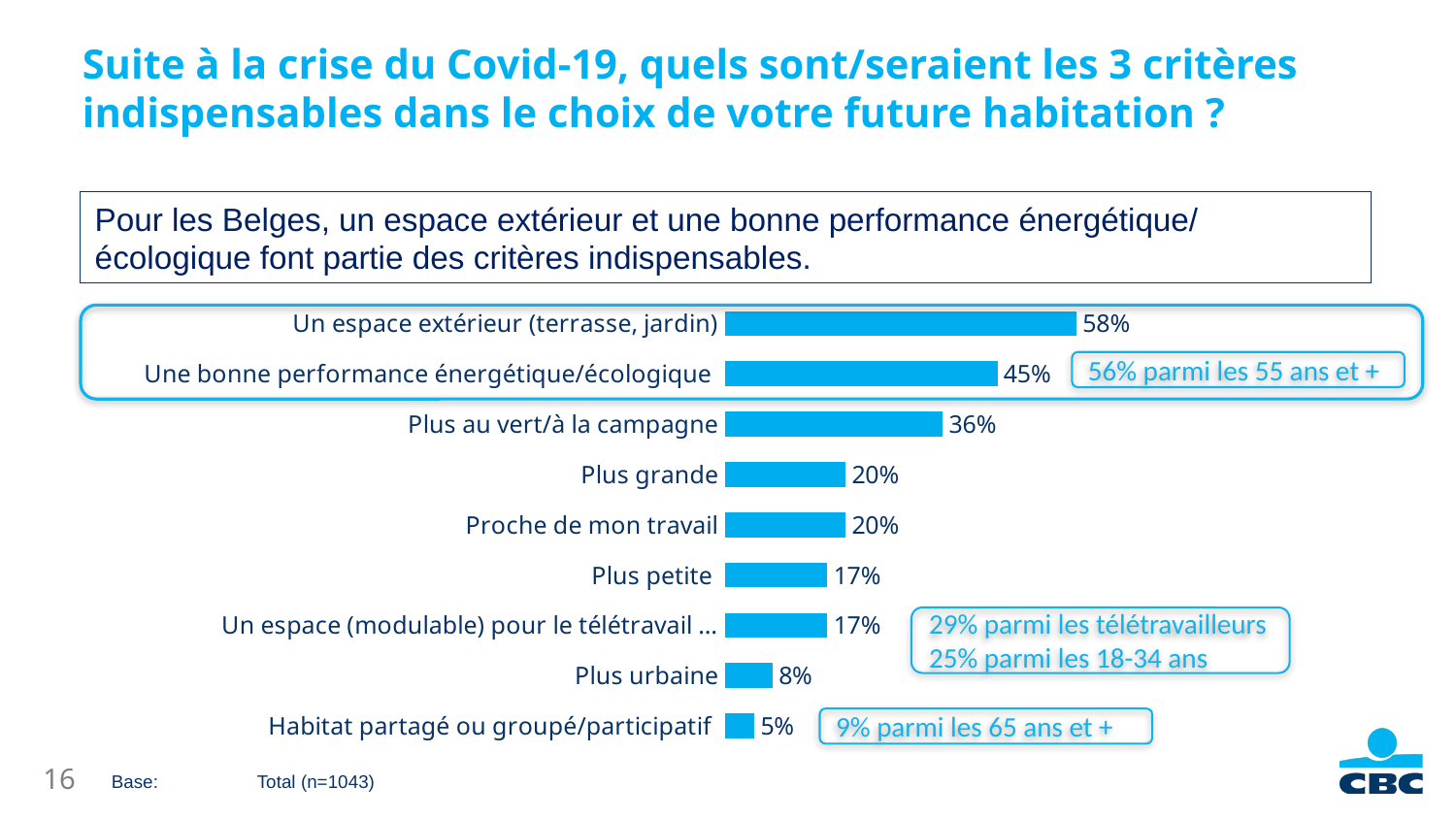
Which category has the lowest value? Habitat partagé ou groupé/participatif What is the difference between "Plus petite" and "Plus urbaine"? 9% What is the sample size (base) stated on the slide? n=1043 What is the value for "Plus urbaine"? 8% What is the value for "Plus au vert/à la campagne"? 36% What is the difference between "Un espace extérieur (terrasse, jardin)" and "Une bonne performance énergétique/écologique"? 13% Which is larger: "Plus au vert/à la campagne" or "Plus grande"? Plus au vert/à la campagne What percentage of respondents chose "Un espace extérieur (terrasse, jardin)"? 58% According to the callout, what percentage of those aged 55 and over chose "Une bonne performance énergétique/écologique"? 56% Which category has the highest value? Un espace extérieur (terrasse, jardin) How many categories are shown in the chart? 9 What kind of chart is shown on the slide? Bar chart